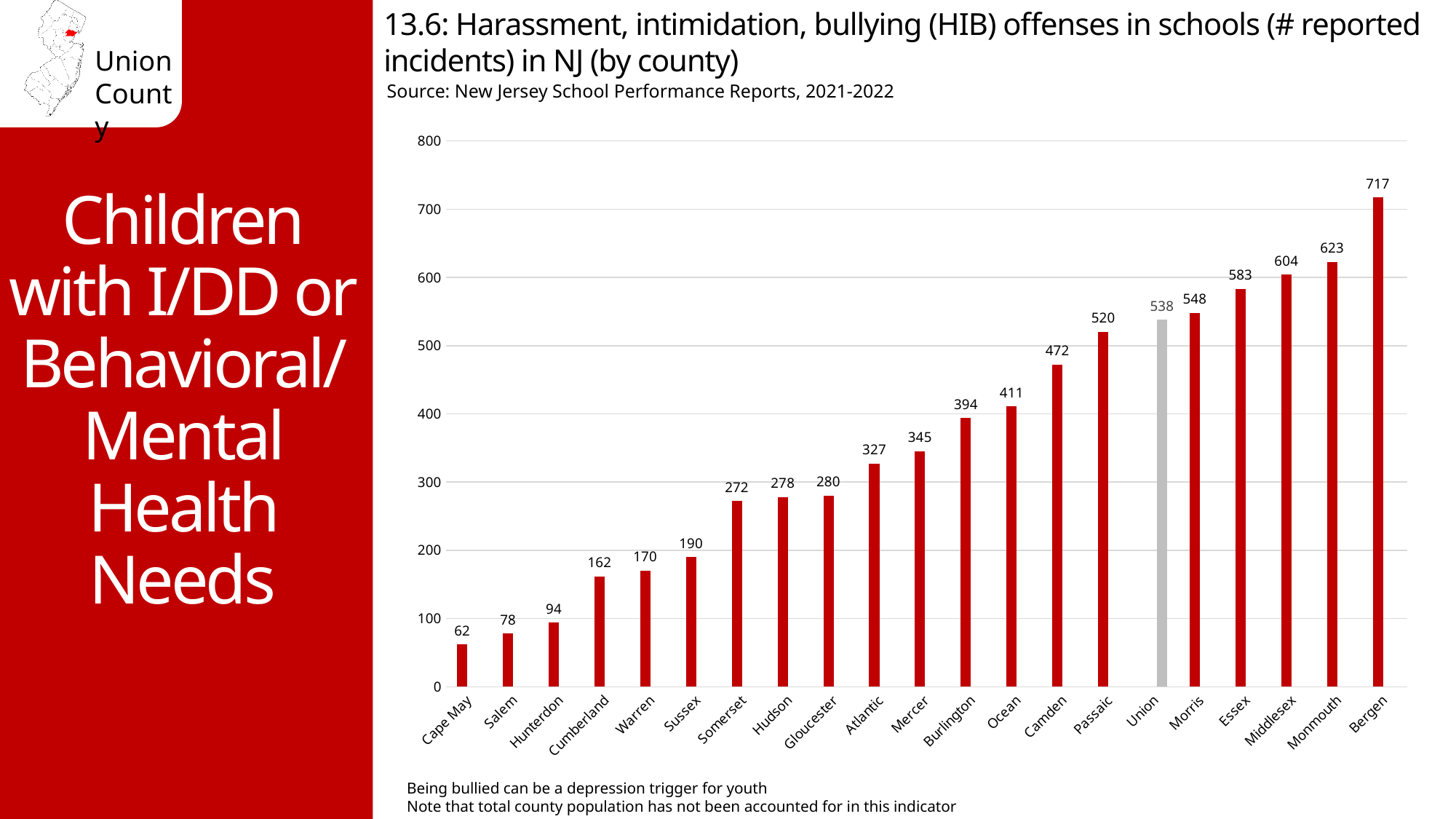
Do the values rise or fall moving from left to right along the x axis? Rise Which county has the lowest number of reported HIB incidents? Cape May Is the value for Monmouth greater or less than 600? greater Which county has the highest number of reported HIB incidents? Bergen How many counties are shown on the chart? 21 What is the difference in reported HIB incidents between Bergen and Union? 179 Which county has more reported HIB incidents, Morris or Ocean? Morris Which county's bar is shown in grey instead of red? Union What is the number of reported HIB incidents for Union county? 538 What kind of chart is used to show HIB incidents by county? Bar chart What is the number of reported HIB incidents for Hudson county? 278 What is the difference in reported HIB incidents between Passaic and Camden? 48